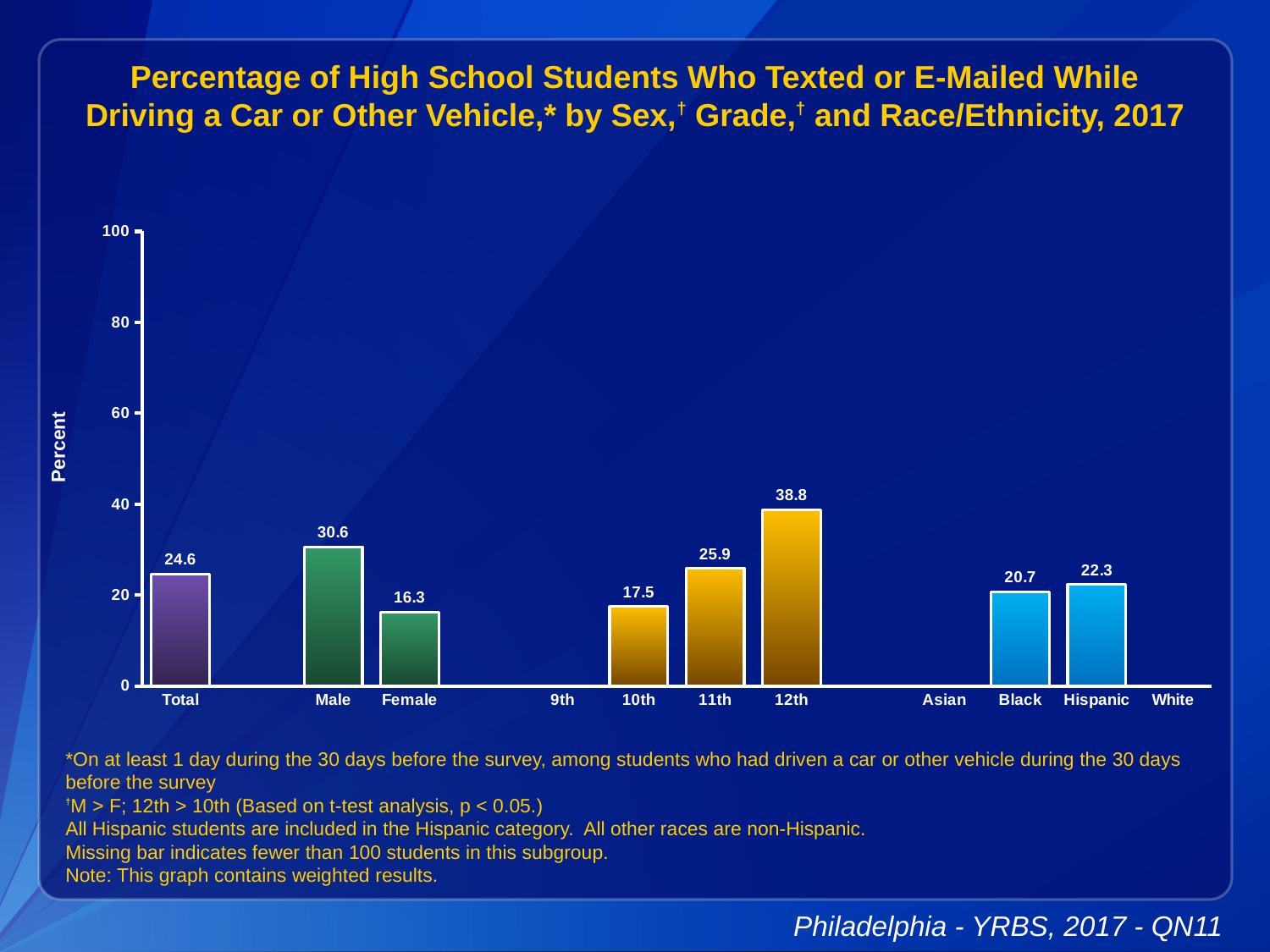
How many categories have a plotted bar? 8 What is the value for 12th grade? 38.8 What is the difference between the Male and Female values? 14.3 What is the value for Total? 24.6 What is the value for Male? 30.6 Do the values rise or fall from 10th grade to 12th grade? rise Which category with a plotted bar has the lowest value? Female What is the value for Hispanic? 22.3 Is the value for 11th grade greater or less than 20? greater Which category has the highest value? 12th Which is larger, the value for Black or the value for Hispanic? Hispanic What kind of chart is shown? bar chart